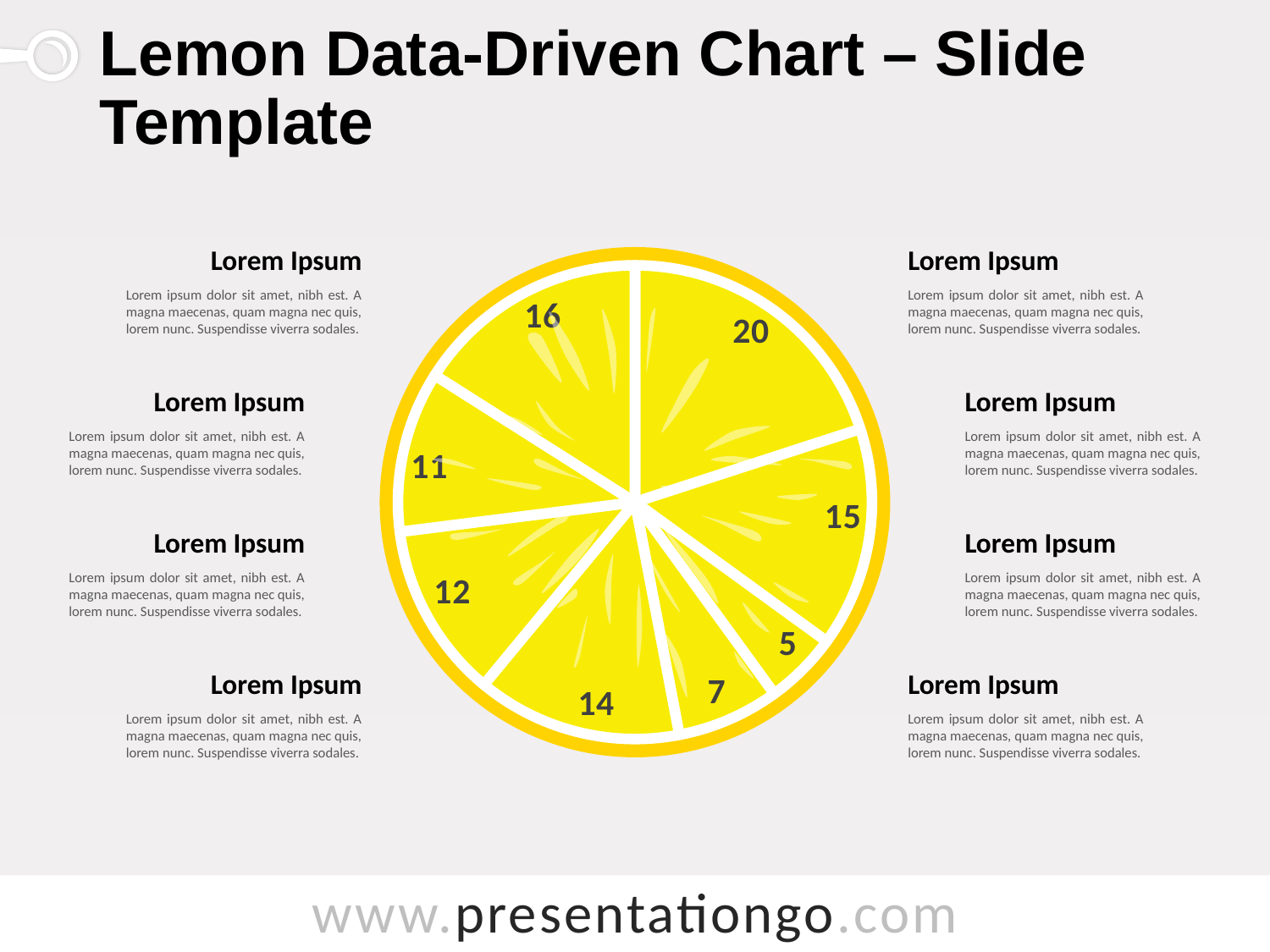
What is the value of the smallest slice in the pie chart? 5 How many slices in the pie chart have a value greater than 10? 6 What is the total of all the slice values in the pie chart? 100 Which is larger, the slice labeled 16 or the slice labeled 15? 16 How many slices does the pie chart have? 8 What is the title of the slide? Lemon Data-Driven Chart – Slide Template What colour are the slices of the pie chart? yellow What share of the pie does the largest slice (20) represent? 20% What share of the pie does the smallest slice (5) represent? 5% What kind of chart is shown on the slide? pie chart What is the difference between the largest and smallest slice values in the pie chart? 15 What is the value of the largest slice in the pie chart? 20